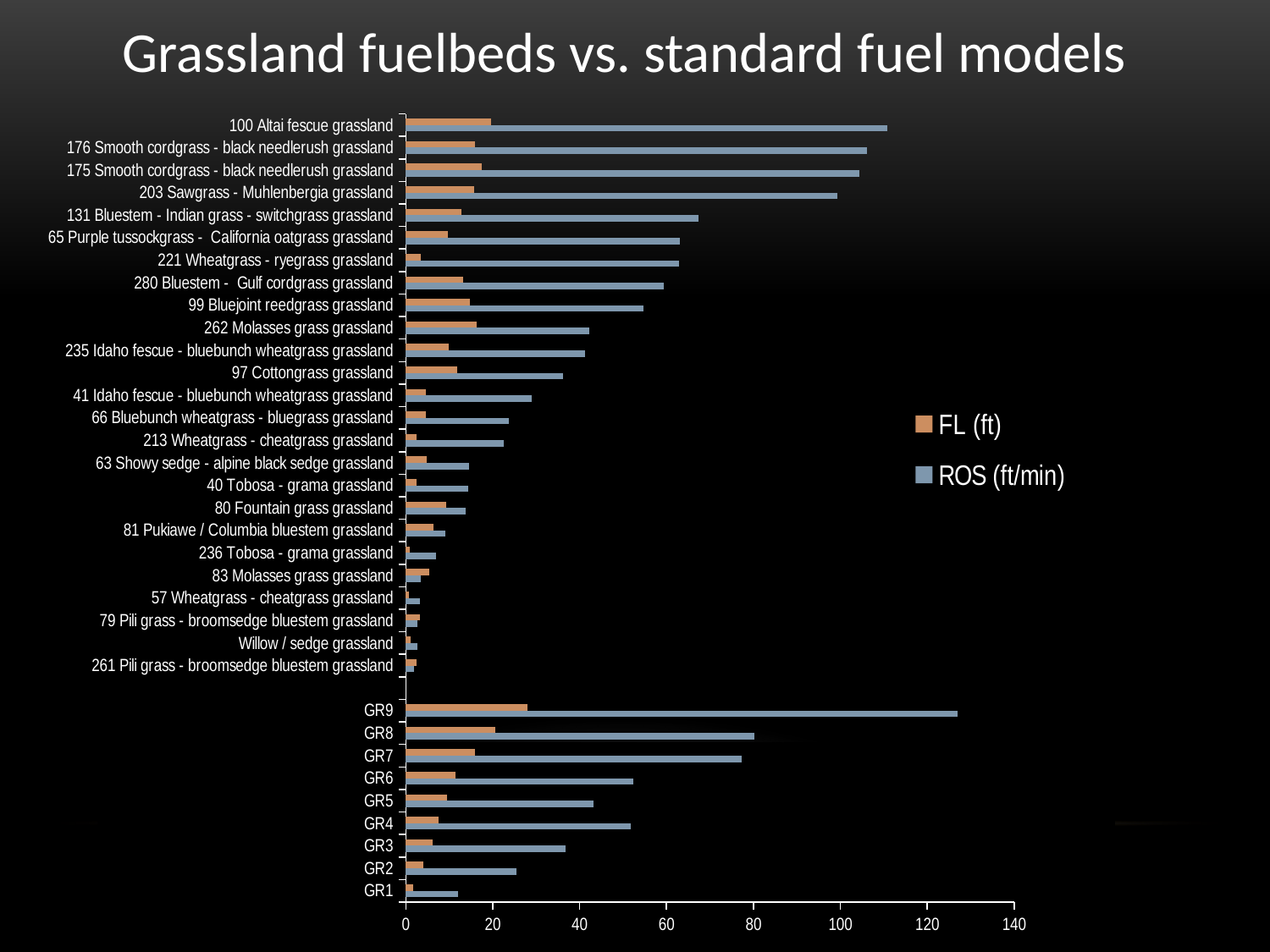
Is the ROS (ft/min) value for 131 Bluestem - Indian grass - switchgrass grassland greater or less than 60? greater How many series does the legend list? 2 Among the grassland fuelbeds (excluding the GR models), which has the highest ROS (ft/min)? 100 Altai fescue grassland Which has the larger ROS (ft/min) value, GR4 or GR5? GR4 What kind of chart is shown on the slide? bar chart Is the ROS (ft/min) value for GR1 greater or less than 20? less How many standard fuel models (GR categories) are plotted? 9 What is the title of the chart? Grassland fuelbeds vs. standard fuel models Which category has the highest ROS (ft/min) value? GR9 Is the ROS (ft/min) value for GR9 greater or less than 120? greater What are the two series named in the legend? FL (ft) and ROS (ft/min)